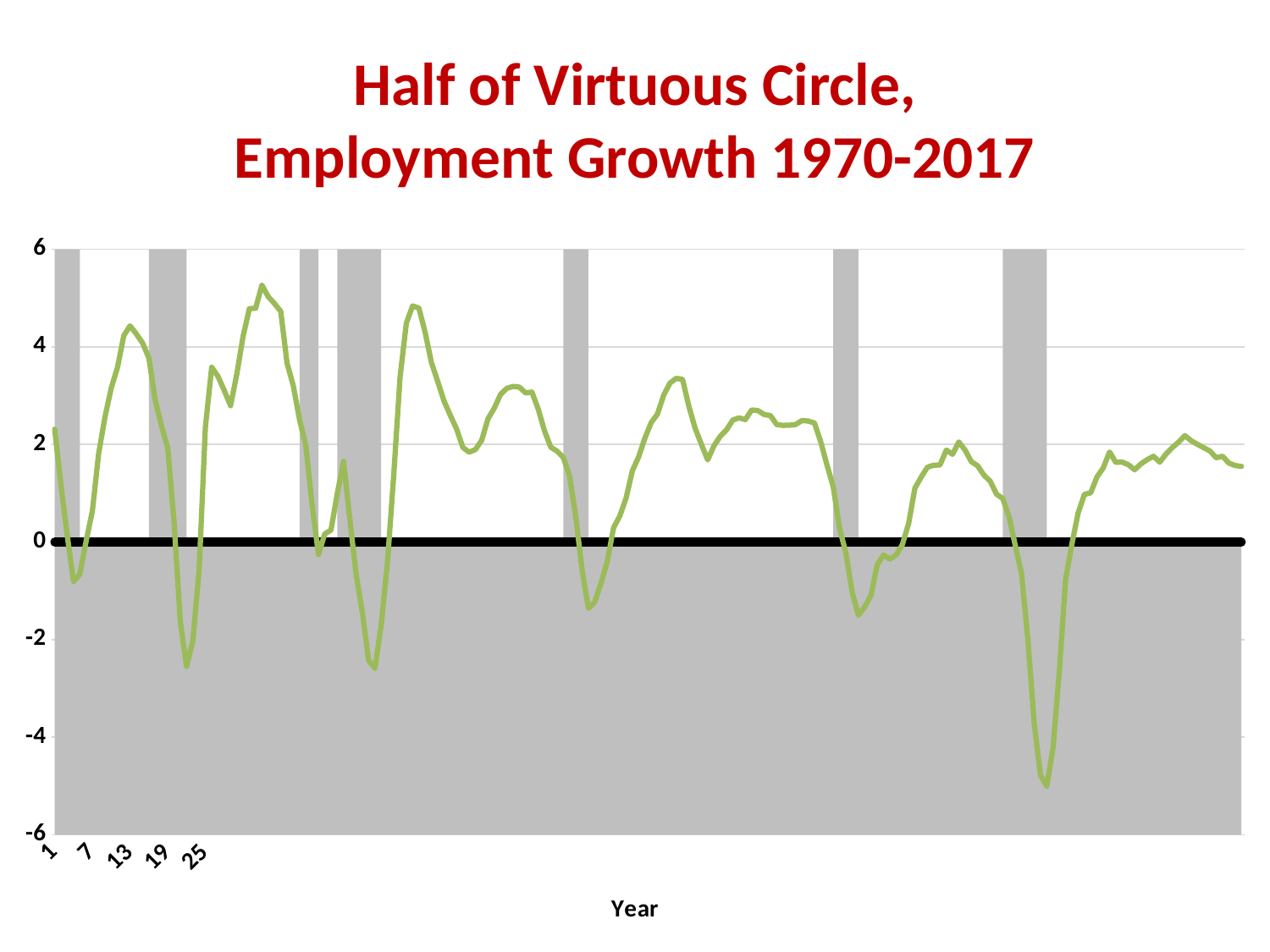
What is the label on the x axis of the chart? Year Is the lowest point of the line greater or less than -4? less What is the title of the chart? Half of Virtuous Circle, Employment Growth 1970-2017 Which is larger: the highest peak in the left half of the chart or the highest peak in the right half of the chart? the left half Is the highest point of the line greater or less than 4? greater Is the deepest trough in the first half of the chart greater or less than -2? less What is the highest value shown on the y axis? 6 What kind of chart is shown on the slide? line chart Do the peaks of the line generally get higher or lower moving from left to right along the x axis? lower